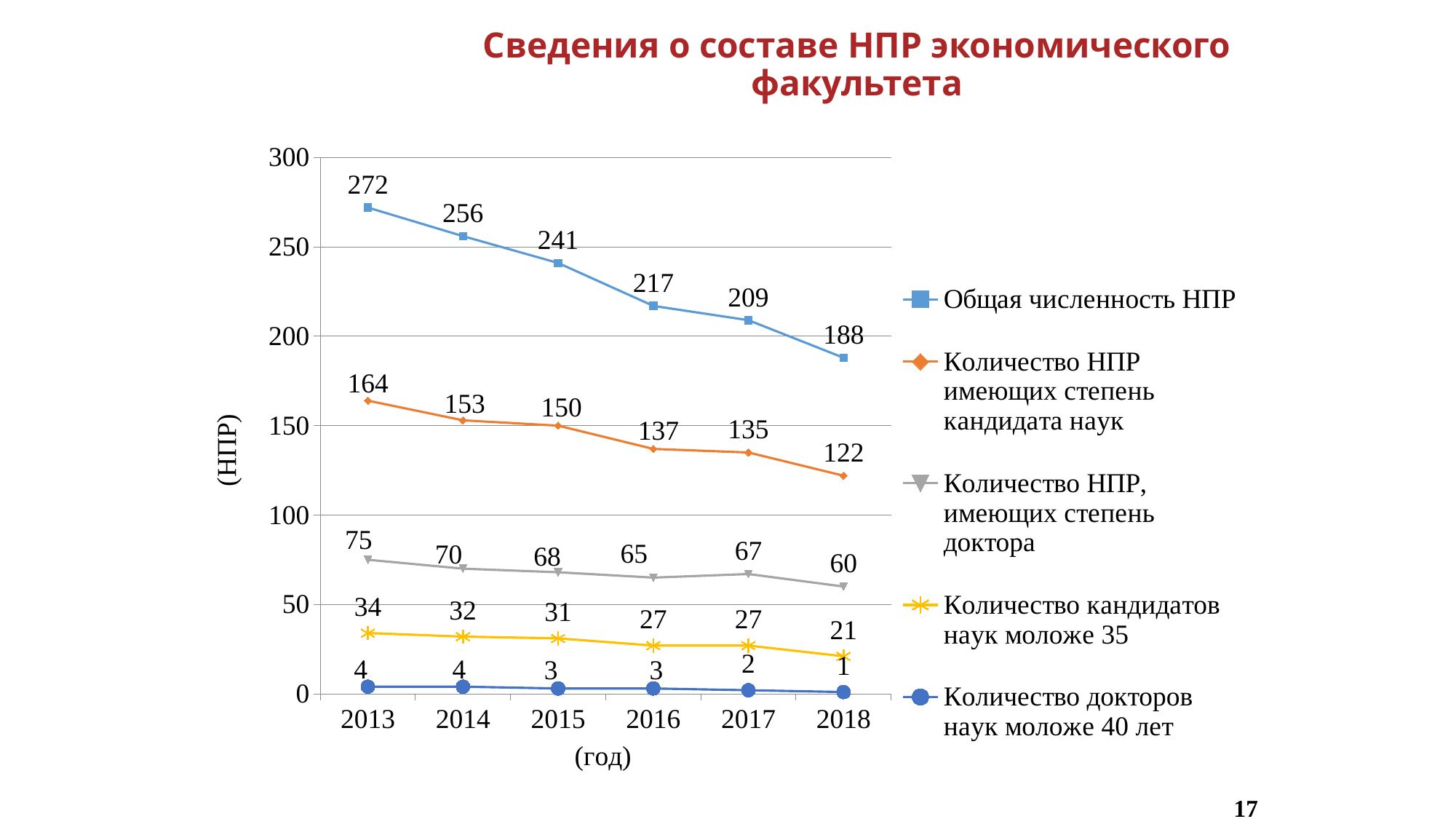
In which year is Количество НПР, имеющих степень доктора highest? 2013 Does Общая численность НПР rise or fall from 2013 to 2018? Fall What is the value of Количество кандидатов наук моложе 35 in 2015? 31 What is the value of Количество НПР имеющих степень кандидата наук in 2018? 122 What is the value of Общая численность НПР in 2013? 272 How many series does the legend list? 5 In which year is Общая численность НПР lowest? 2018 How many years are shown on the x axis? 6 What is the value of Количество НПР, имеющих степень доктора in 2016? 65 What is the difference between Общая численность НПР in 2013 and in 2018? 84 What kind of chart is shown on the slide? Line chart Which is larger: Количество НПР, имеющих степень доктора in 2016 or in 2017? 2017